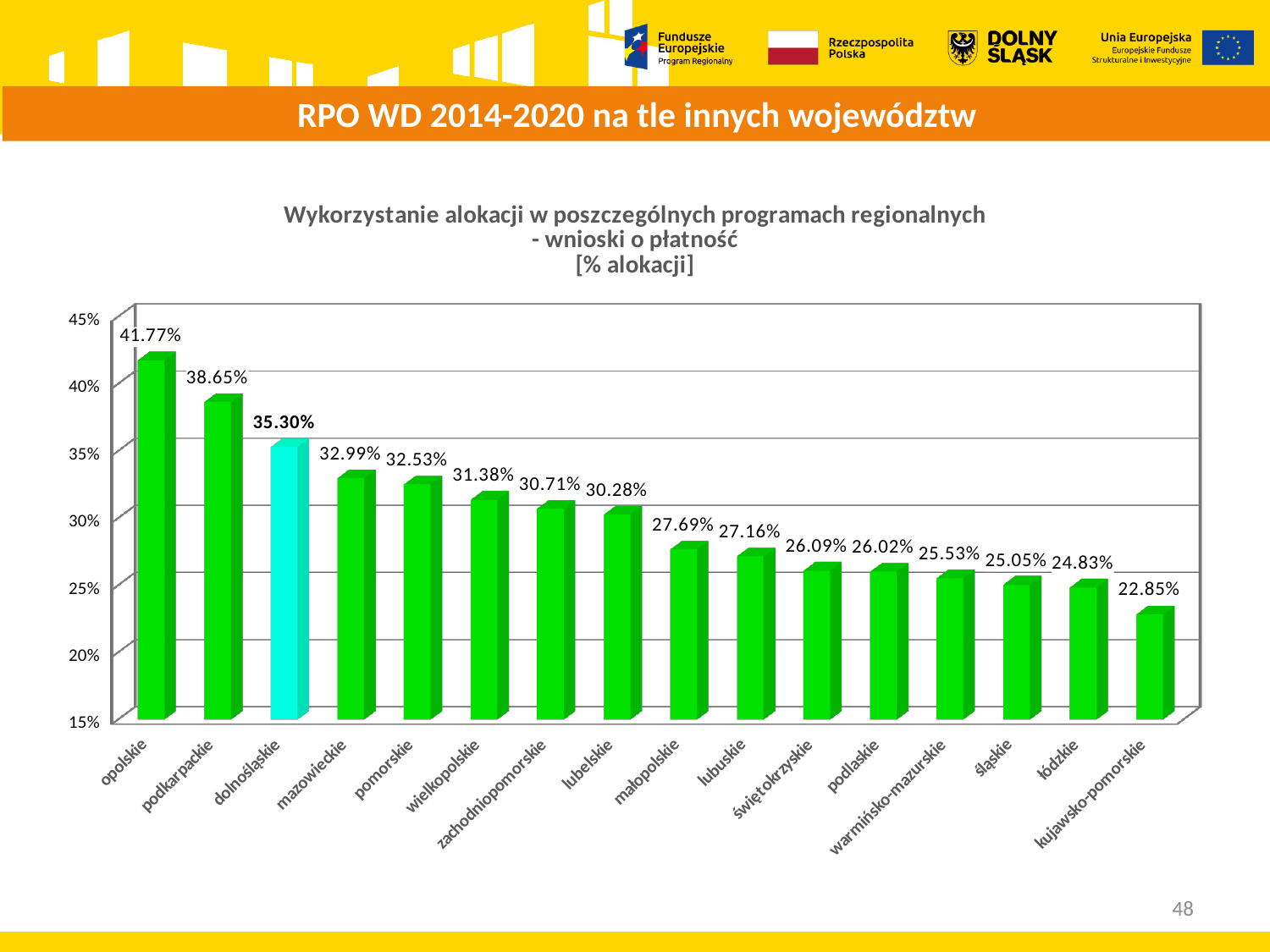
What is the value for mazowieckie? 32.99% Which voivodeship has the lowest value? kujawsko-pomorskie What kind of chart is shown on the slide? bar chart What is the value for dolnośląskie? 35.30% Which is larger, the value for pomorskie or the value for wielkopolskie? pomorskie Is the value for lubelskie greater or less than 30%? greater What is the difference between the values for opolskie and podkarpackie? 3.12% Which voivodeship has the highest value? opolskie How many voivodeships are shown on the chart? 16 Do the values rise or fall from left to right along the x axis? fall What is the difference between the values for dolnośląskie and kujawsko-pomorskie? 12.45% What is the value for lubuskie? 27.16%